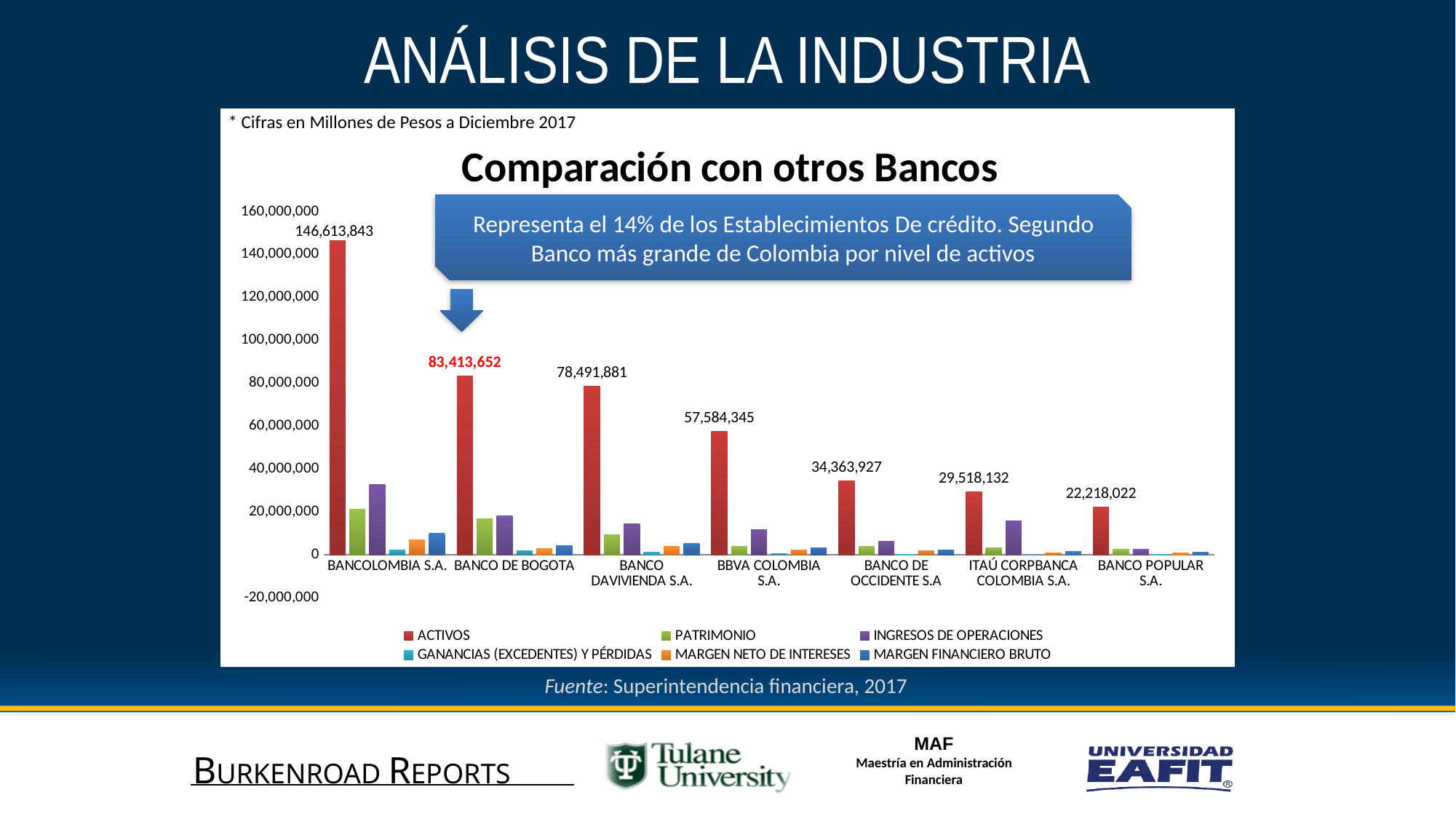
Which bank has the lowest ACTIVOS value? BANCO POPULAR S.A. What is the ACTIVOS value for BANCO DE BOGOTA? 83,413,652 How many banks are shown on the x axis of the chart? 7 What is the difference in ACTIVOS between BANCOLOMBIA S.A. and BANCO DE BOGOTA? 63,200,191 What is the ACTIVOS value for BANCOLOMBIA S.A.? 146,613,843 Is the INGRESOS DE OPERACIONES value for BANCOLOMBIA S.A. greater or less than 20,000,000? greater What type of chart is shown on the slide? Bar chart What is the title of the chart? Comparación con otros Bancos What is the ACTIVOS value for BANCO POPULAR S.A.? 22,218,022 Which bank has the highest ACTIVOS value? BANCOLOMBIA S.A. Which has a larger ACTIVOS value, BBVA COLOMBIA S.A. or BANCO DE OCCIDENTE S.A? BBVA COLOMBIA S.A. How many series does the legend list? 6